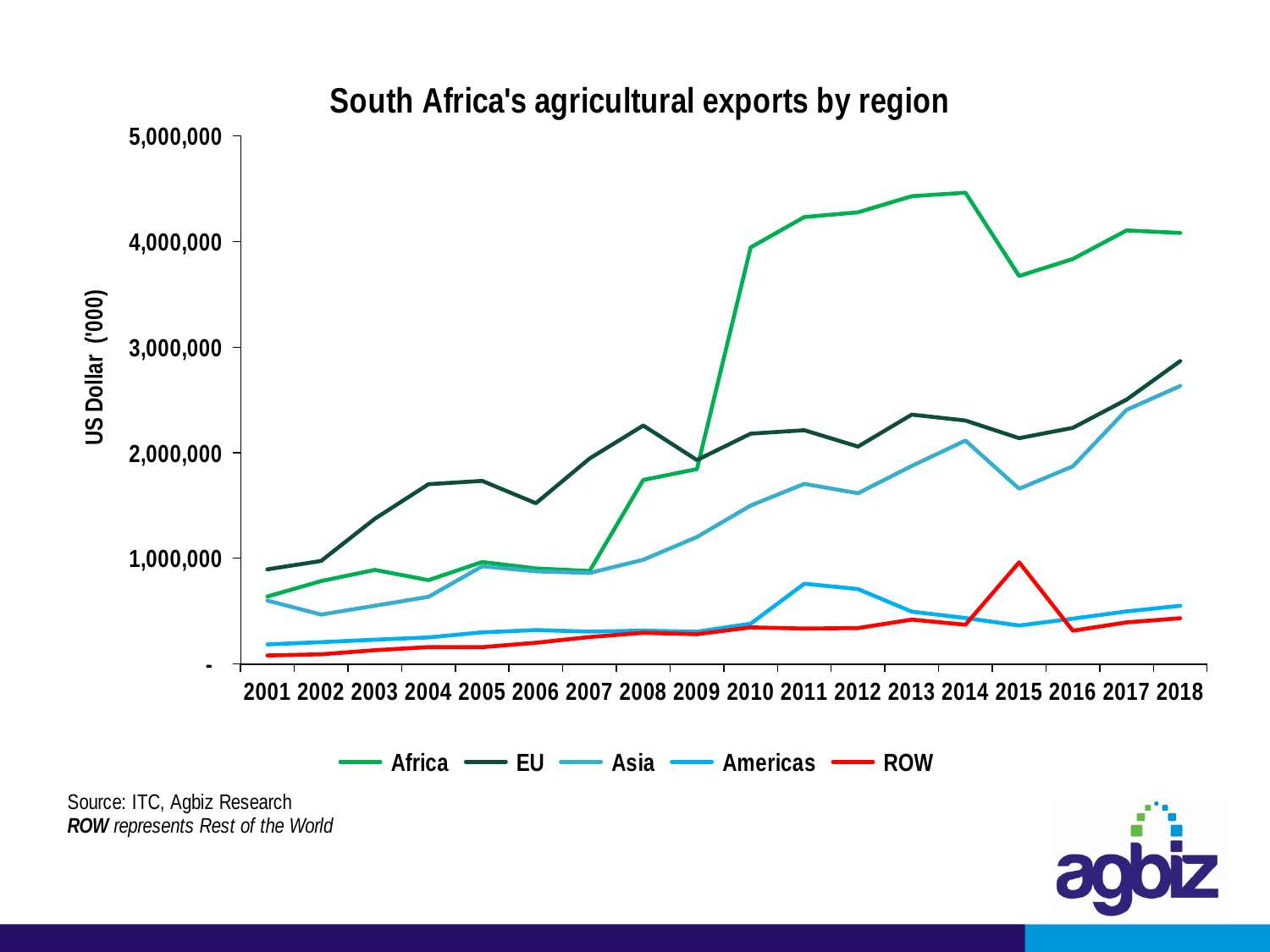
Which region had the lowest agricultural exports in 2001? ROW In 2011, which was larger: exports to Asia or exports to the Americas? Asia What kind of chart is shown on the slide? line chart Which region had the highest agricultural exports in 2008? EU What is the label on the y axis? US Dollar ('000) Did exports to Asia rise or fall between 2015 and 2018? rise Which region had the highest agricultural exports in 2018? Africa How many years are shown on the x axis? 18 How many series does the legend list? 5 Is the value for EU in 2001 greater or less than 1,000,000? less Is the value for Africa in 2014 greater or less than 4,000,000? greater Is the value for ROW in 2015 greater or less than 500,000? greater